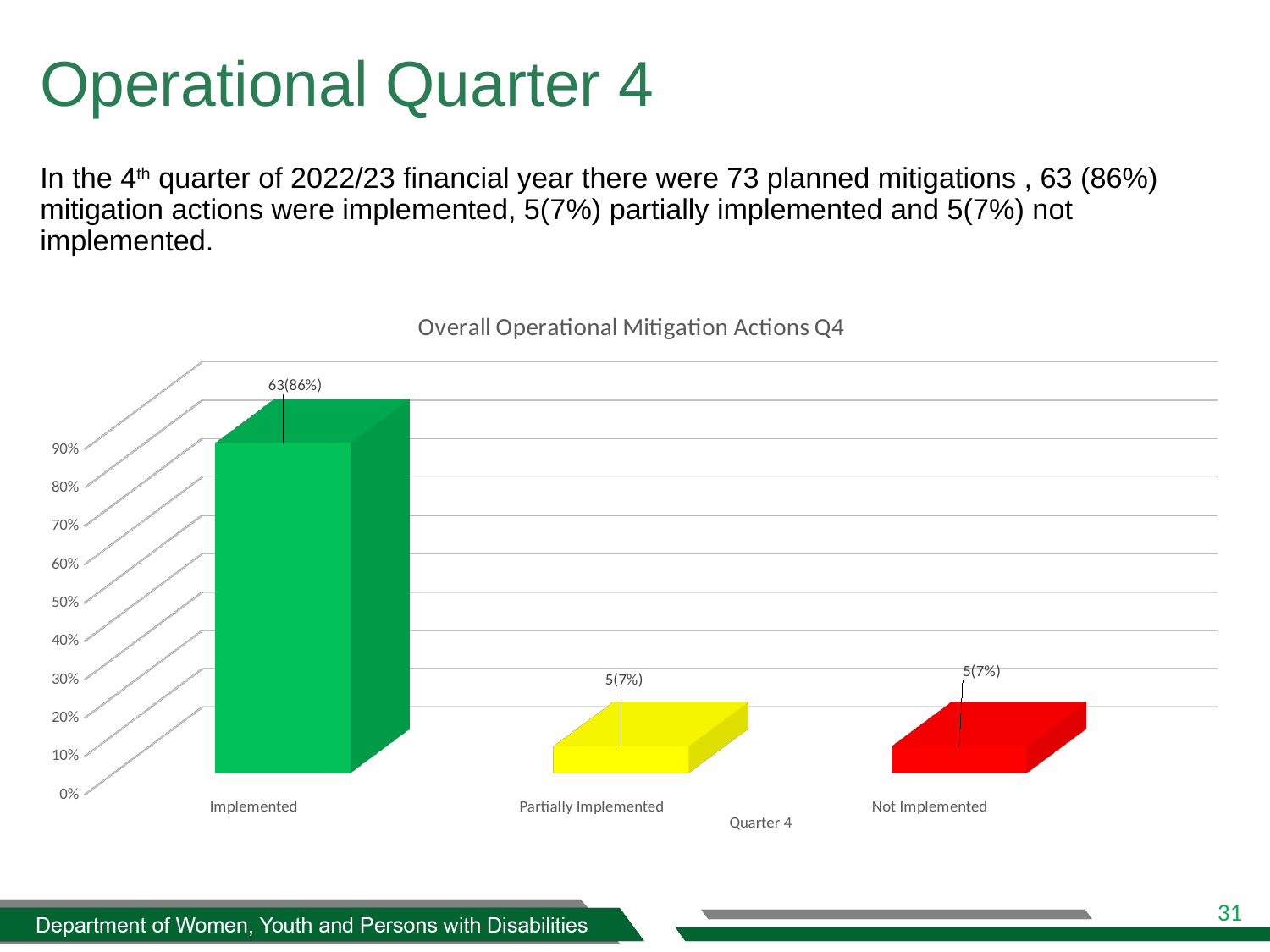
Is the value for Implemented greater or less than 50%? greater What colour is the Not Implemented bar? Red What is the data label shown for the Not Implemented bar? 5(7%) Which category has the highest value? Implemented What is the difference in percentage points between Implemented and Not Implemented? 79% Which is larger, the value for Implemented or the value for Partially Implemented? Implemented Is the value for Not Implemented greater or less than 20%? less What is the data label shown for the Partially Implemented bar? 5(7%) What is the data label shown for the Implemented bar? 63(86%) What kind of chart is shown on the slide? Bar chart What is the title of the chart? Overall Operational Mitigation Actions Q4 How many categories are shown on the x axis? 3